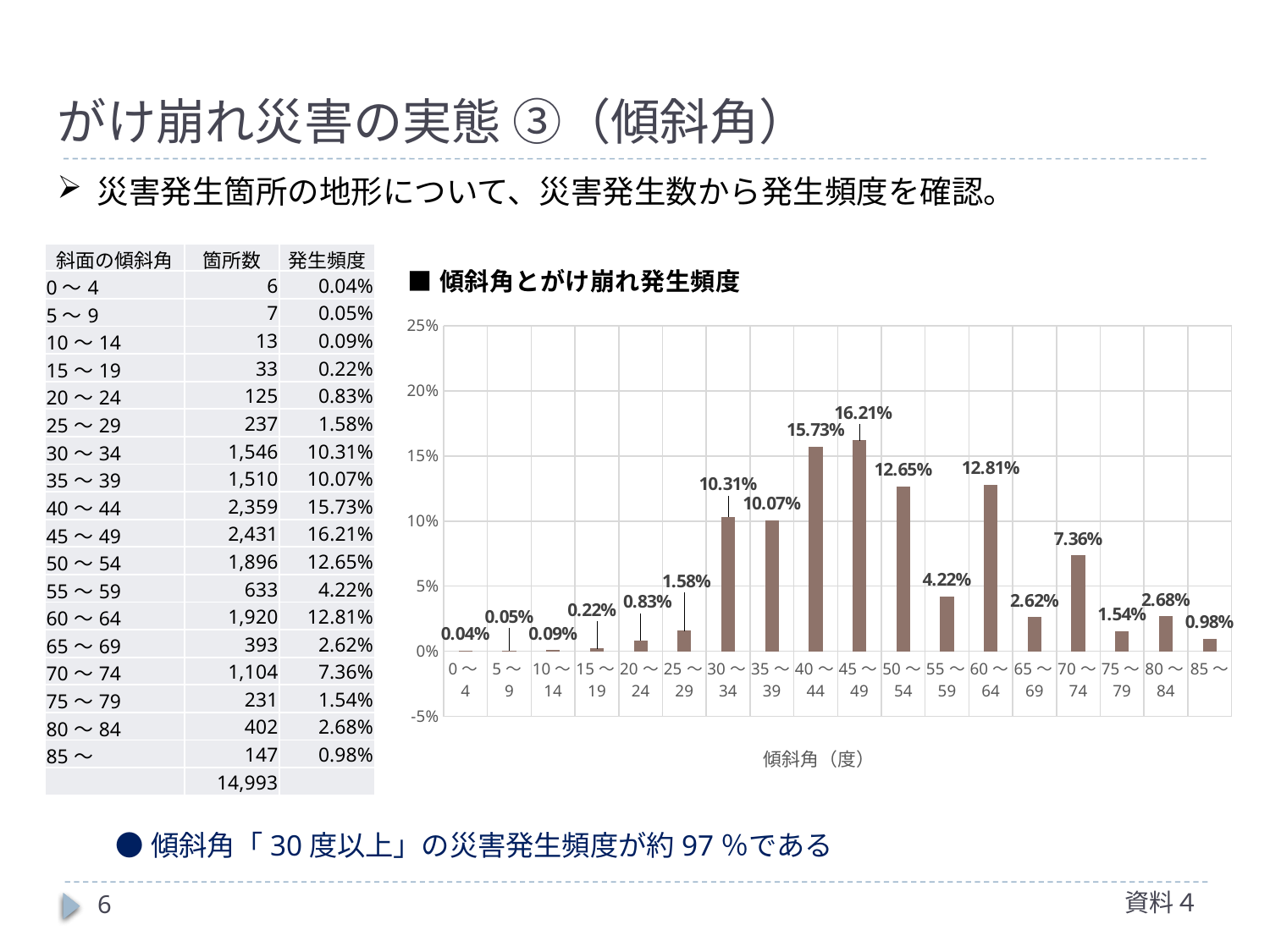
What is the value for the 45～49 category? 16.21% What is the value for the 30～34 category? 10.31% What is the difference between the values for 45～49 and 40～44? 0.48% What is the title of the chart? 傾斜角とがけ崩れ発生頻度 How many categories are shown on the x axis? 18 Is the value for 70～74 greater or less than 5%? greater Which category has the lowest value? 0～4 Which category has the highest value? 45～49 What is the value for the 85～ category? 0.98% Do the values rise or fall from the 0～4 category to the 45～49 category? rise Which is larger, the value for 60～64 or the value for 50～54? 60～64 What type of chart is shown on the slide? bar chart